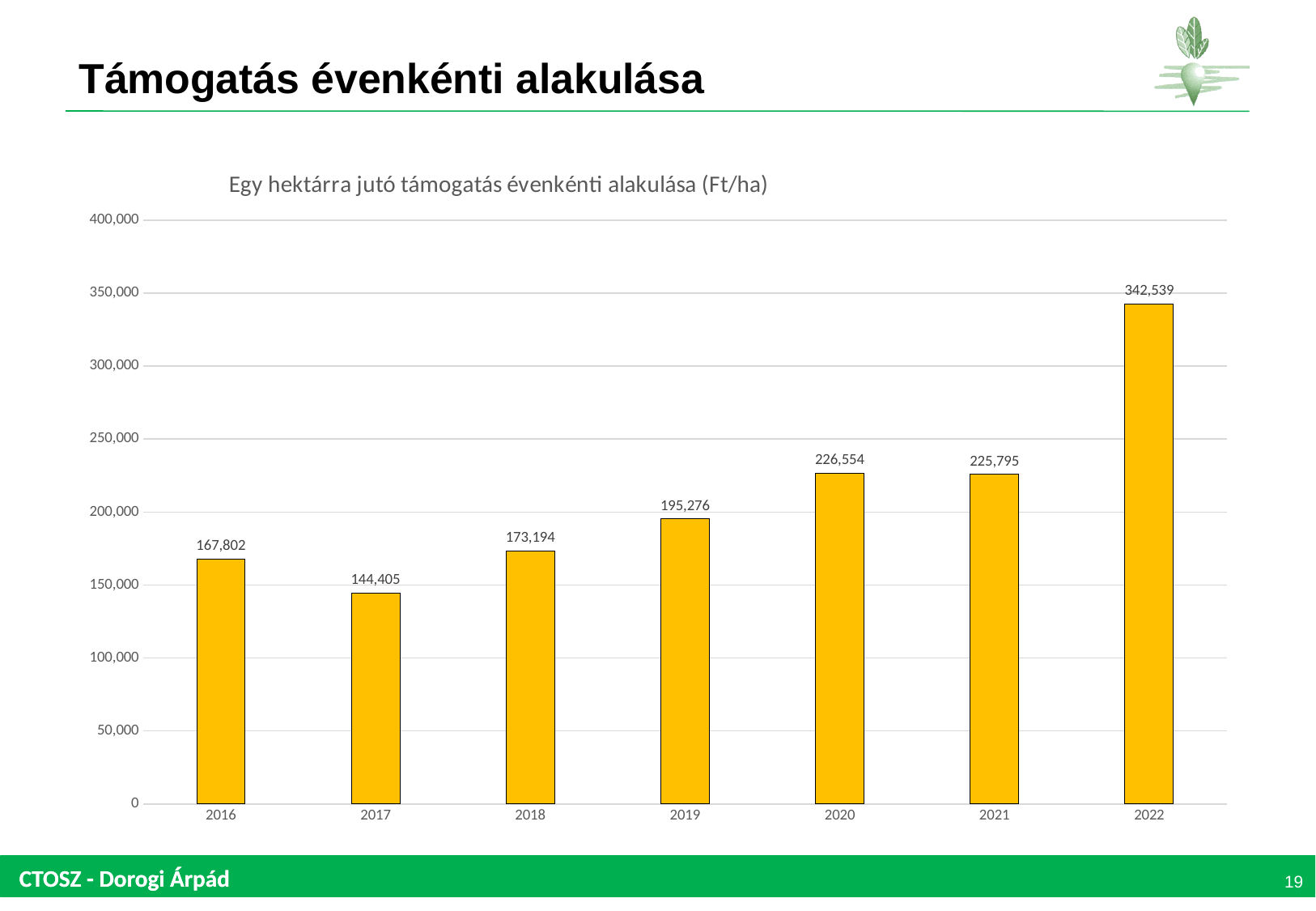
What is the value for 2022? 342,539 How many years are shown on the x axis? 7 What is the difference between the values for 2018 and 2017? 28,789 Is the value for 2022 greater or less than 300,000? greater What is the value for 2019? 195,276 Which is larger, the value for 2020 or the value for 2019? 2020 Which year has the highest value? 2022 What kind of chart is this? bar chart What is the title of the chart? Egy hektárra jutó támogatás évenkénti alakulása (Ft/ha) Which year has the lowest value? 2017 What is the difference between the values for 2022 and 2021? 116,744 What is the value for 2016? 167,802